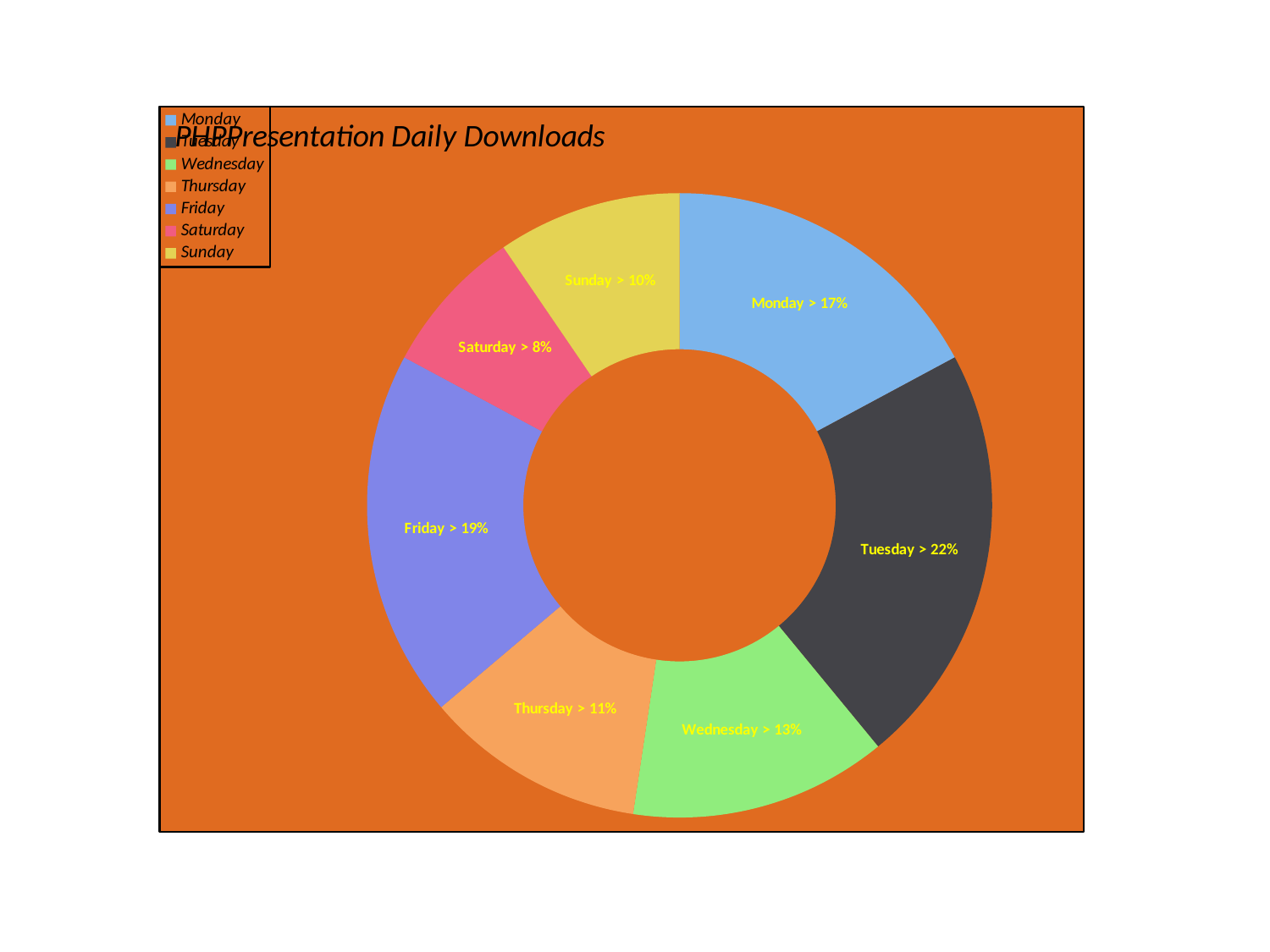
What is the difference in percentage points between Tuesday's and Monday's shares? 5 What colour is the Friday segment? Purple/blue What kind of chart is shown on the slide? Doughnut (pie) chart Which day has the largest share of downloads? Tuesday How many days are shown in the chart? 7 What share of daily downloads does Saturday account for? 8% Which has a larger share, Thursday or Sunday? Thursday What is the title of the chart? PHPPresentation Daily Downloads What share of daily downloads does Wednesday account for? 13% What share of daily downloads does Friday account for? 19% Which day has the smallest share of downloads? Saturday What share of daily downloads does Tuesday account for? 22%